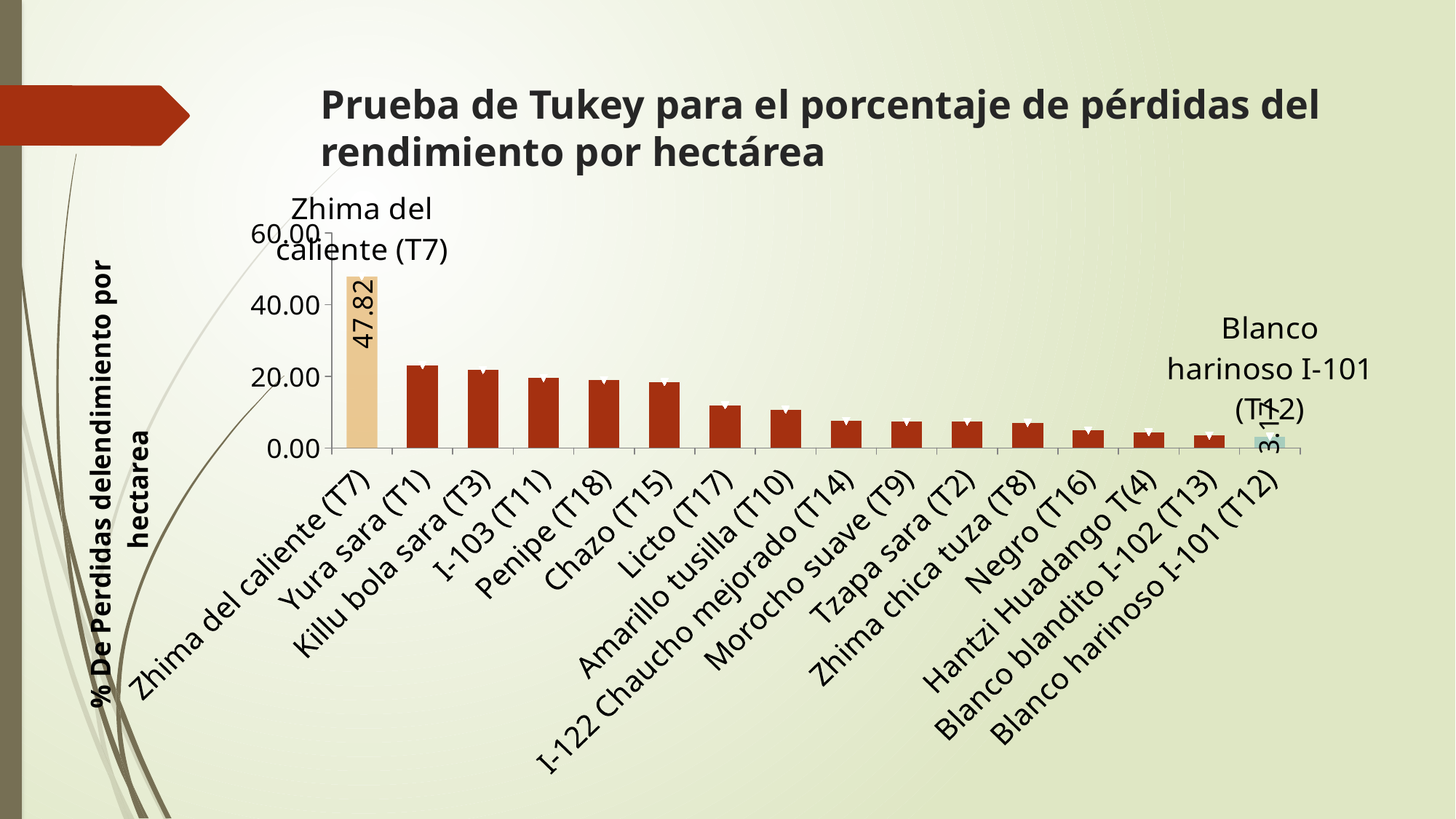
Which is larger, the value for Chazo (T15) or the value for Negro (T16)? Chazo (T15) Is the value for Yura sara (T1) greater or less than 20.00? greater What kind of chart is shown on the slide? bar chart Is the value for Zhima del caliente (T7) greater or less than 40.00? greater Is the value for Licto (T17) greater or less than 20.00? less How many categories are plotted on the chart? 16 Do the values rise or fall from left to right along the x axis? fall Which is larger, the value for Yura sara (T1) or the value for Licto (T17)? Yura sara (T1) Which category has the highest value? Zhima del caliente (T7) Which category has the lowest value? Blanco harinoso I-101 (T12) What is the title of the chart? Prueba de Tukey para el porcentaje de pérdidas del rendimiento por hectárea What is the value for Zhima del caliente (T7)? 47.82